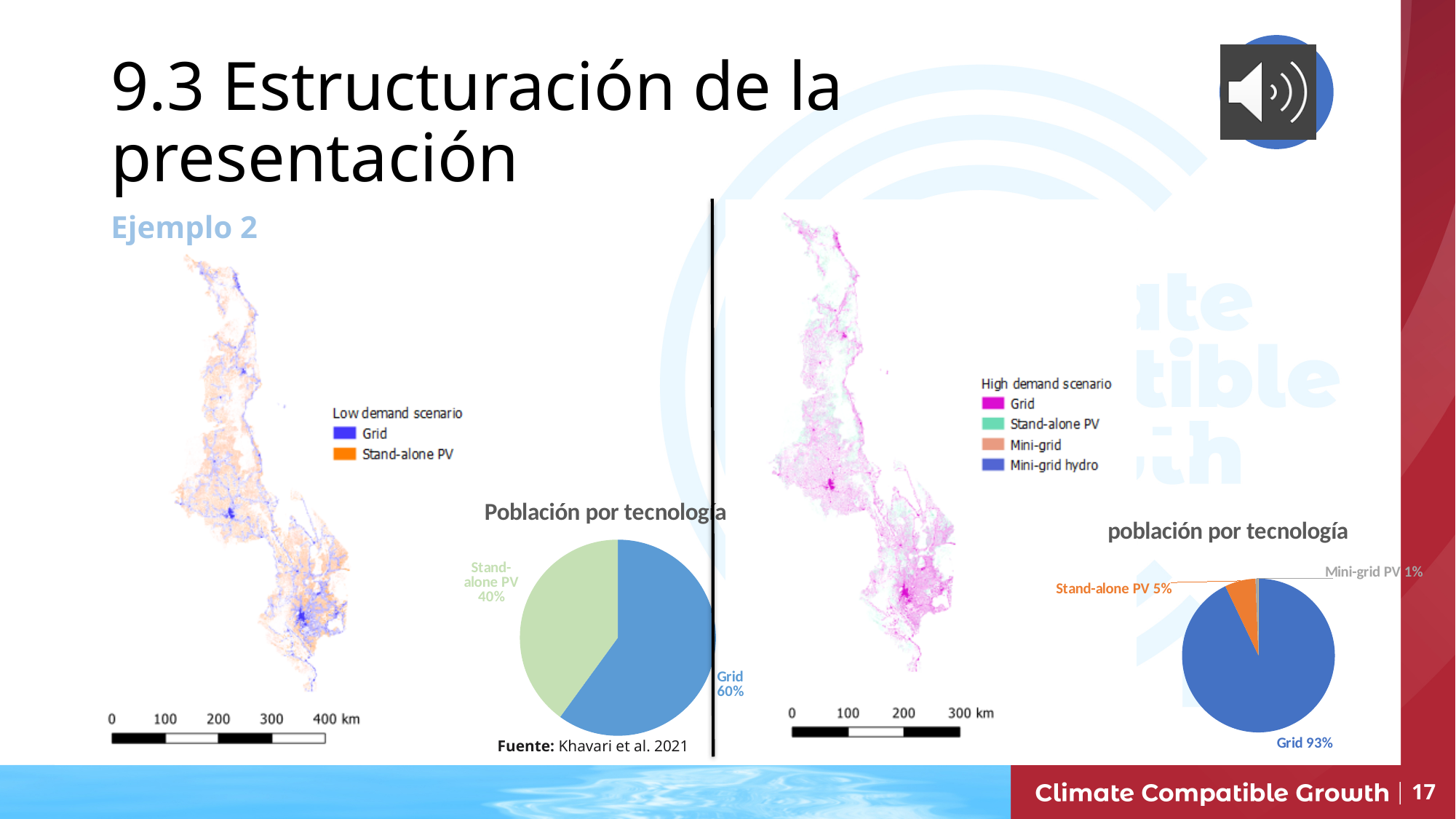
In the right pie chart (población por tecnología), which is larger: the Stand-alone PV share or the Mini-grid PV share? Stand-alone PV What kind of chart is the left chart titled Población por tecnología? Pie chart In the right pie chart (población por tecnología), what share of the population is served by Stand-alone PV? 5% How many slices does the left pie chart (Población por tecnología) have? 2 In the left pie chart (Población por tecnología), what share of the population is served by Grid? 60% In the right pie chart (población por tecnología), what share of the population is served by Grid? 93% In the left pie chart (Población por tecnología), which technology has the largest share? Grid In the left pie chart (Población por tecnología), what is the difference in percentage points between the Grid and Stand-alone PV shares? 20 percentage points In the right pie chart (población por tecnología), what share of the population is served by Mini-grid PV? 1% In the left pie chart (Población por tecnología), what share of the population is served by Stand-alone PV? 40%